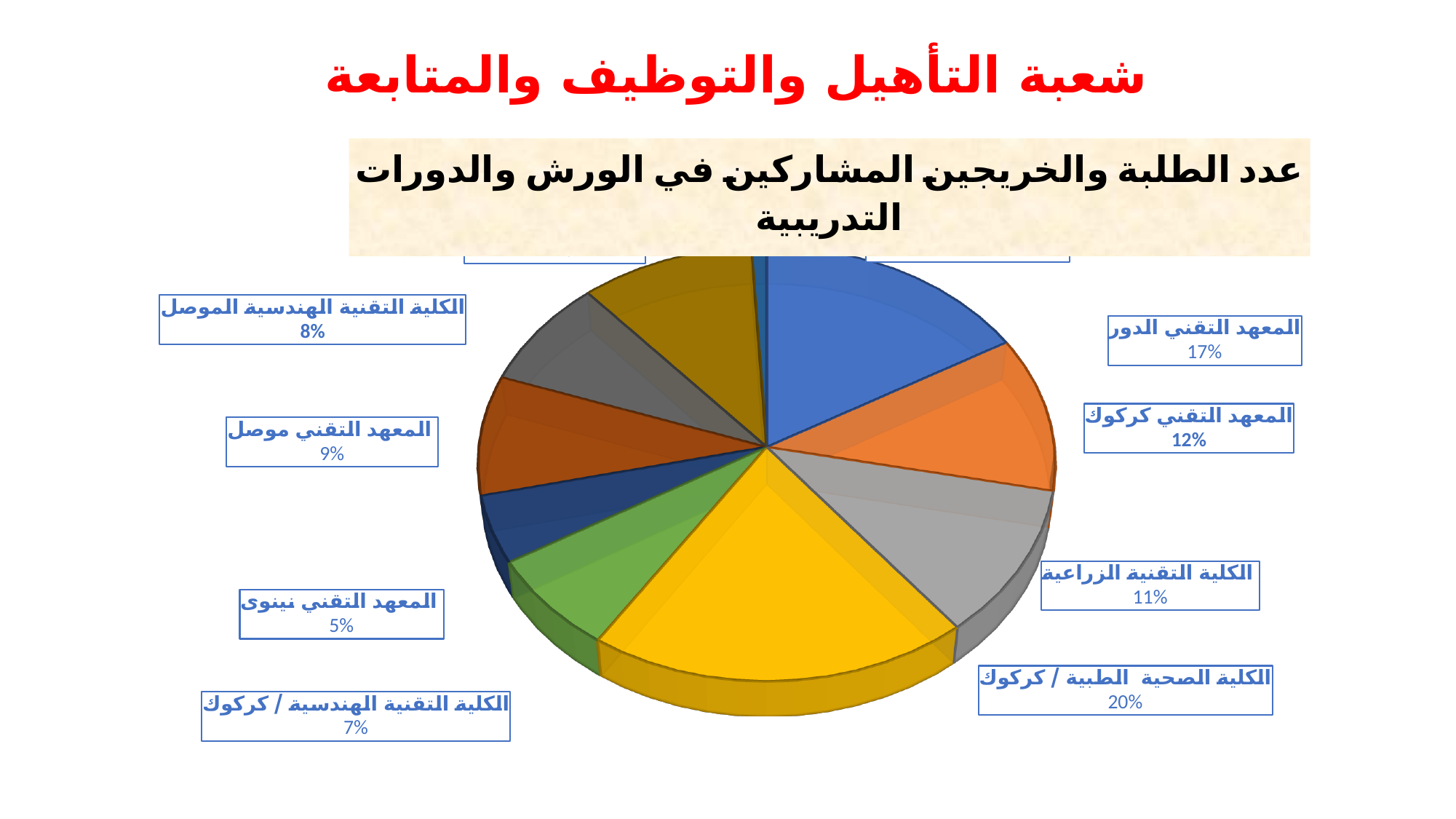
What percentage is shown for المعهد التقني نينوى? 5% What percentage is shown for المعهد التقني كركوك? 12% What percentage is shown for الكلية التقنية الهندسية الموصل? 8% What is the title shown above the chart? عدد الطلبة والخريجين المشاركين في الورش والدورات التدريبية What percentage is shown for الكلية التقنية الزراعية? 11% Which labelled category has the largest share of the pie? الكلية الصحية الطبية / كركوك What is the difference in percentage points between الكلية الصحية الطبية / كركوك and المعهد التقني نينوى? 15 What share of the pie does الكلية الصحية الطبية / كركوك have? 20% What percentage is shown for المعهد التقني الدور? 17% What is the difference in percentage points between المعهد التقني الدور and المعهد التقني كركوك? 5 What kind of chart is shown on the slide? pie chart Which has a larger share, المعهد التقني موصل or الكلية التقنية الهندسية / كركوك? المعهد التقني موصل